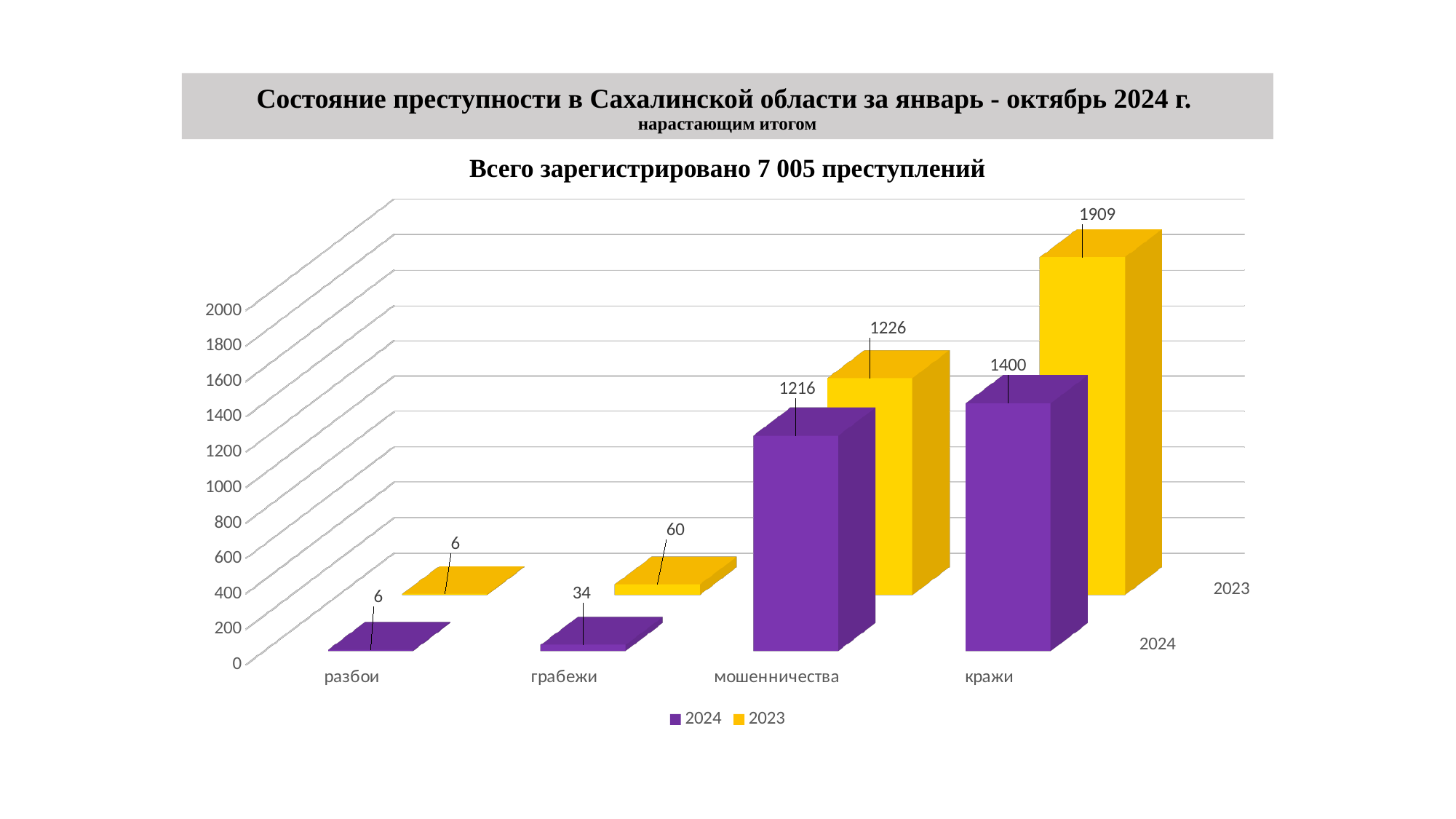
What is the value for мошенничества in the 2023 series? 1226 Which is larger for мошенничества: the 2024 value or the 2023 value? 2023 What kind of chart is shown on the slide? bar chart What is the value for разбои in the 2023 series? 6 Which category has the highest value in the 2023 series? кражи What is the value for грабежи in the 2024 series? 34 What is the difference between the 2023 and 2024 values for кражи? 509 How many series does the legend list? 2 How many categories are shown on the x axis? 4 What is the value for кражи in the 2024 series? 1400 Which category has the lowest value in the 2024 series? разбои What is the difference between the 2023 and 2024 values for грабежи? 26